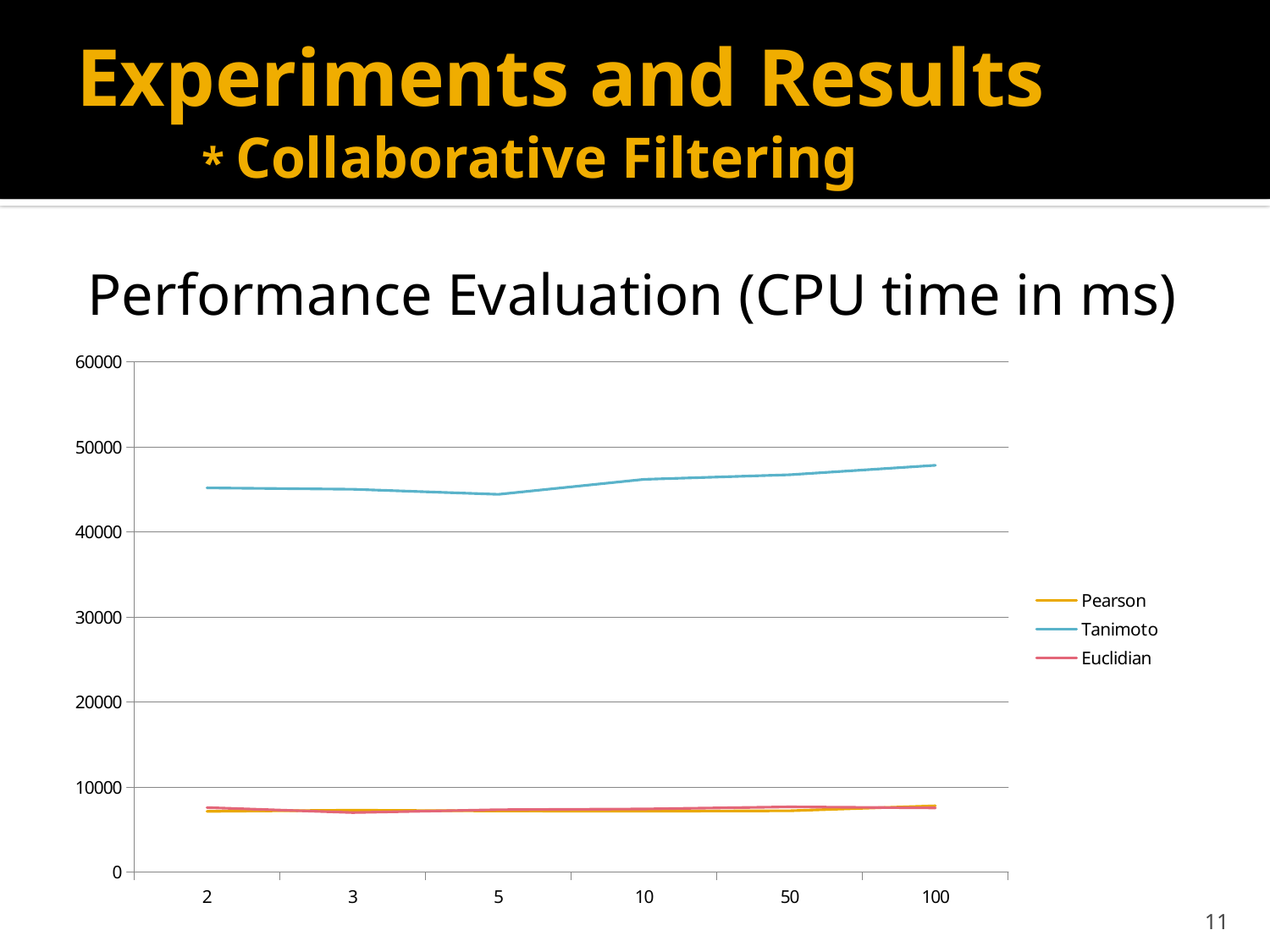
Which series has the highest CPU time across the chart? Tanimoto What is the title of the chart? Performance Evaluation (CPU time in ms) How many series does the legend list? 3 Does the Tanimoto line rise or fall from x = 5 to x = 100? rise How many points are plotted along the x axis for each series? 6 Is the value for Pearson at x = 2 greater or less than 10000? less Which is larger at x = 10, the value for Tanimoto or the value for Pearson? Tanimoto What is the highest value shown on the y axis? 60000 Is the value for Tanimoto at x = 100 greater or less than 40000? greater Is the value for Tanimoto at x = 5 greater or less than 50000? less What kind of chart is shown on the slide? line chart